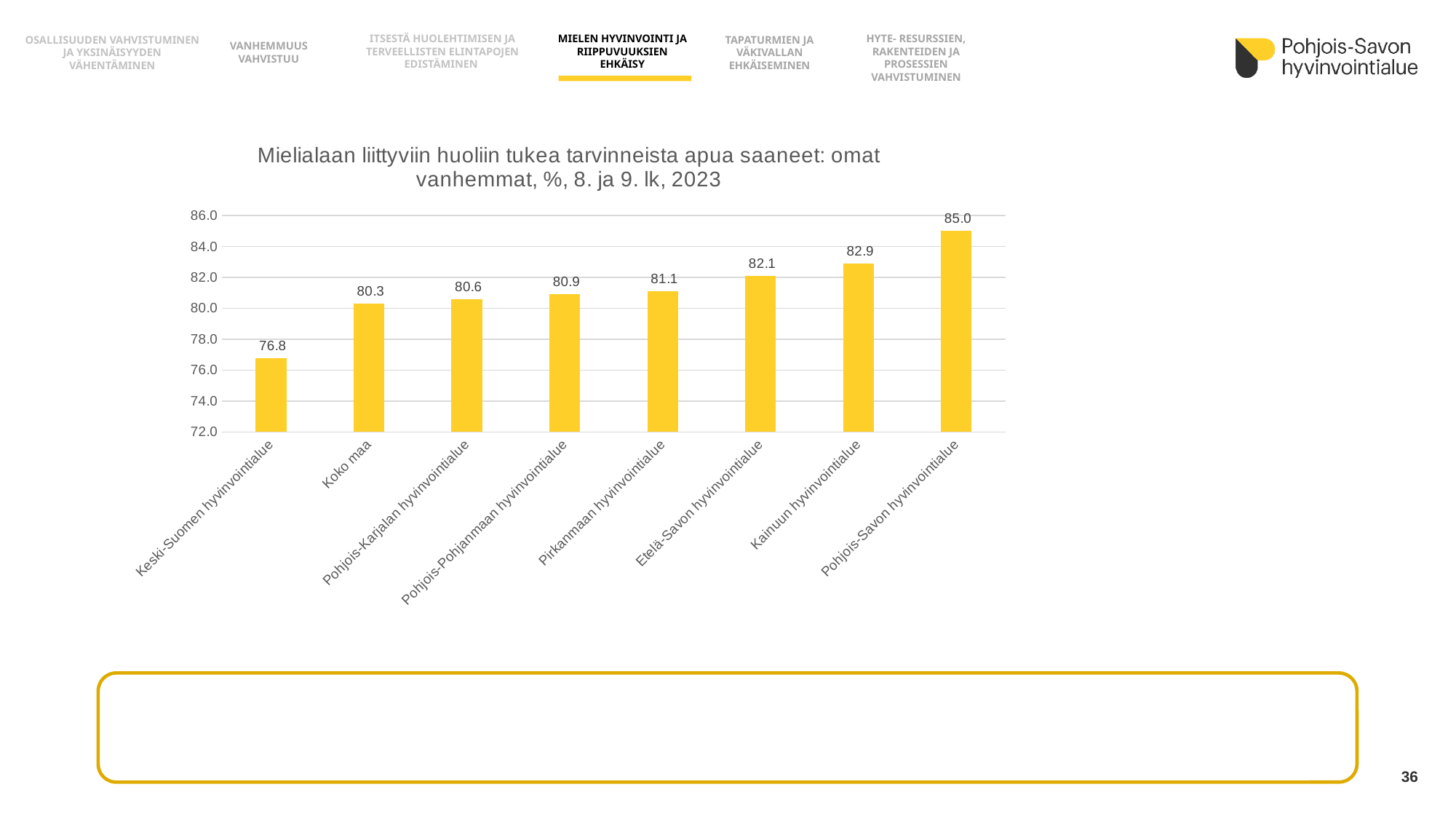
What is the value for Pohjois-Savon hyvinvointialue? 85.0 What is the value for Koko maa? 80.3 How many categories are shown on the x axis? 8 Do the values rise or fall from left to right along the x axis? rise What is the difference between the values for Pohjois-Savon hyvinvointialue and Keski-Suomen hyvinvointialue? 8.2 What kind of chart is shown on the slide? bar chart Which is larger, the value for Etelä-Savon hyvinvointialue or the value for Koko maa? Etelä-Savon hyvinvointialue Is the value for Keski-Suomen hyvinvointialue greater or less than 78.0? less What is the value for Pirkanmaan hyvinvointialue? 81.1 What is the difference between the values for Kainuun hyvinvointialue and Etelä-Savon hyvinvointialue? 0.8 Which category has the lowest value? Keski-Suomen hyvinvointialue Which category has the highest value? Pohjois-Savon hyvinvointialue